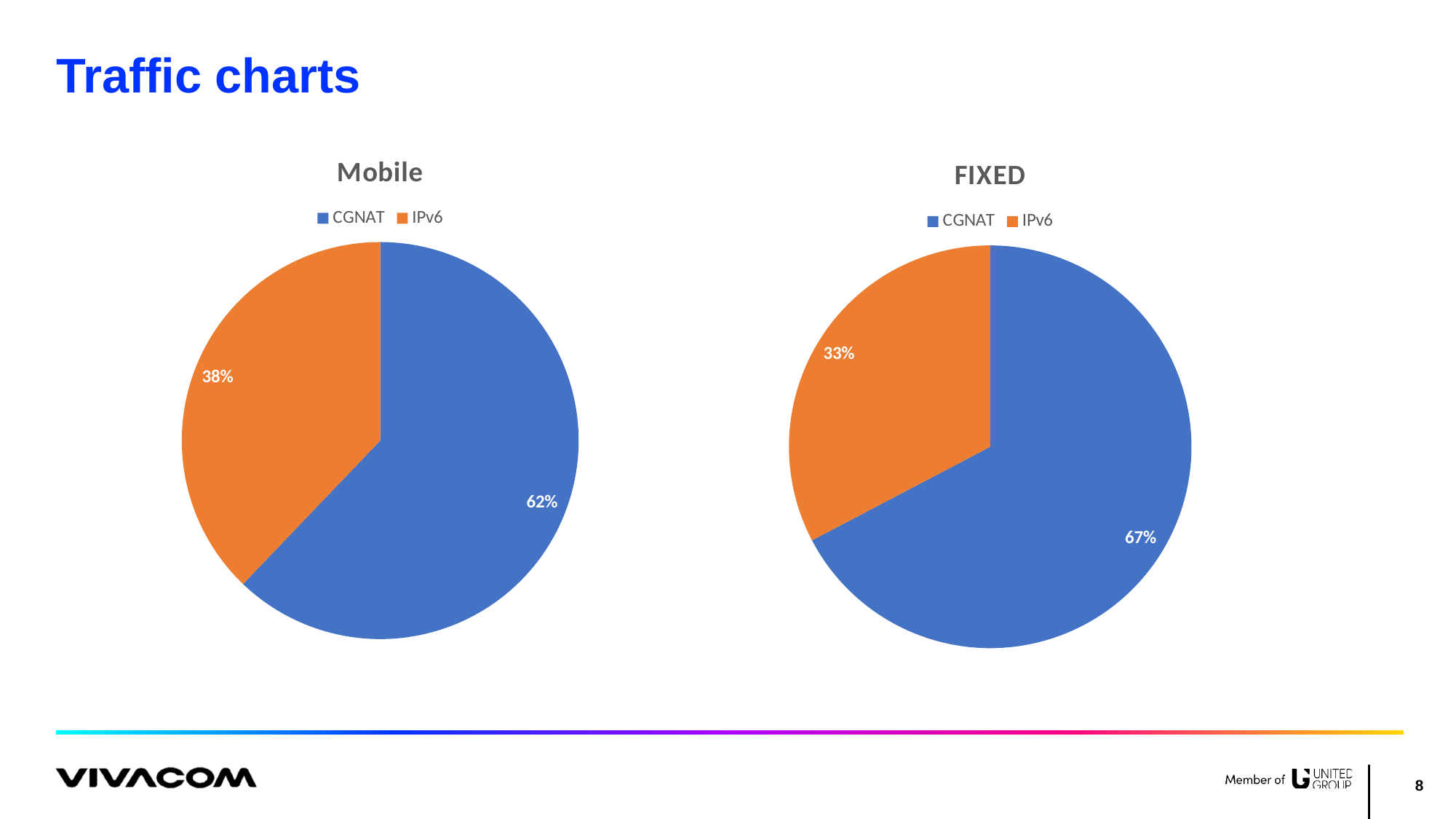
In the FIXED chart, which slice is the smallest? IPv6 In the Mobile chart, which slice is the largest? CGNAT In the FIXED chart, which colour represents IPv6? Orange How many slices does the Mobile pie chart have? 2 In the Mobile chart, what is the difference in percentage points between the CGNAT and IPv6 shares? 24 percentage points In the FIXED chart, what share of traffic is IPv6? 33% In the FIXED chart, what is the difference in percentage points between the CGNAT and IPv6 shares? 34 percentage points In the FIXED chart, what share of traffic is CGNAT? 67% Is the IPv6 share larger in the Mobile chart or the FIXED chart? Mobile In the Mobile chart, what share of traffic is CGNAT? 62% What type of chart is the FIXED chart? Pie chart In the Mobile chart, what share of traffic is IPv6? 38%